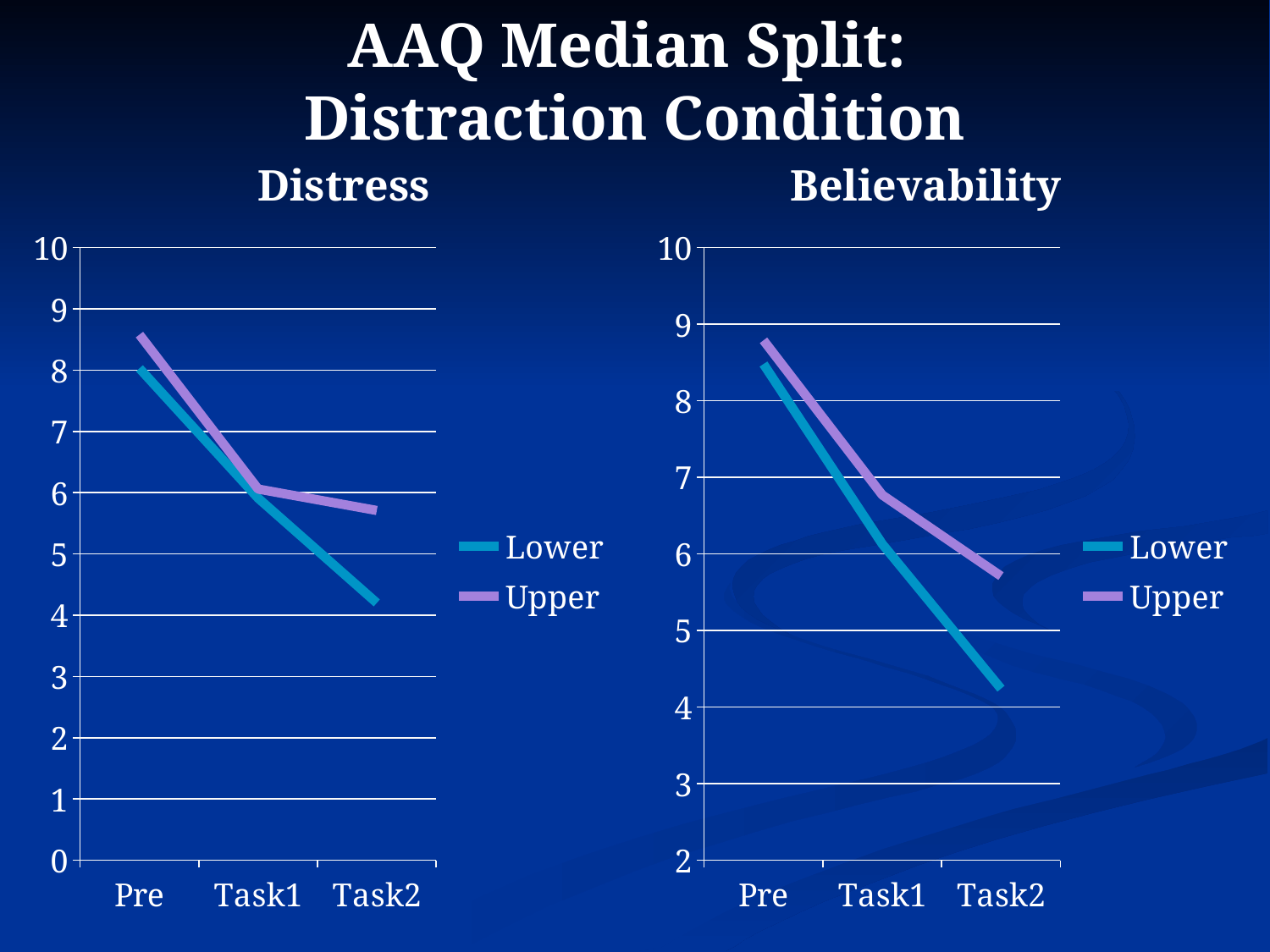
On the Distress chart, what kind of chart is shown? line chart On the Distress chart, which series has the larger value at Task2, Lower or Upper? Upper On the Believability chart, is the Lower value at Task2 greater or less than 5? less On the Distress chart, is the Lower value at Task2 greater or less than 5? less On the Believability chart, what is the lowest value shown on the y axis? 2 On the Distress chart, how many categories are on the x axis? 3 On the Distress chart, how many series does the legend list? 2 On the Believability chart, is the Lower value at Task1 greater or less than 7? less On the Believability chart, does the Upper line rise or fall from Pre to Task2? fall On the Believability chart, which series has the larger value at Task1, Lower or Upper? Upper On the Distress chart, does the Lower line rise or fall from Pre to Task2? fall